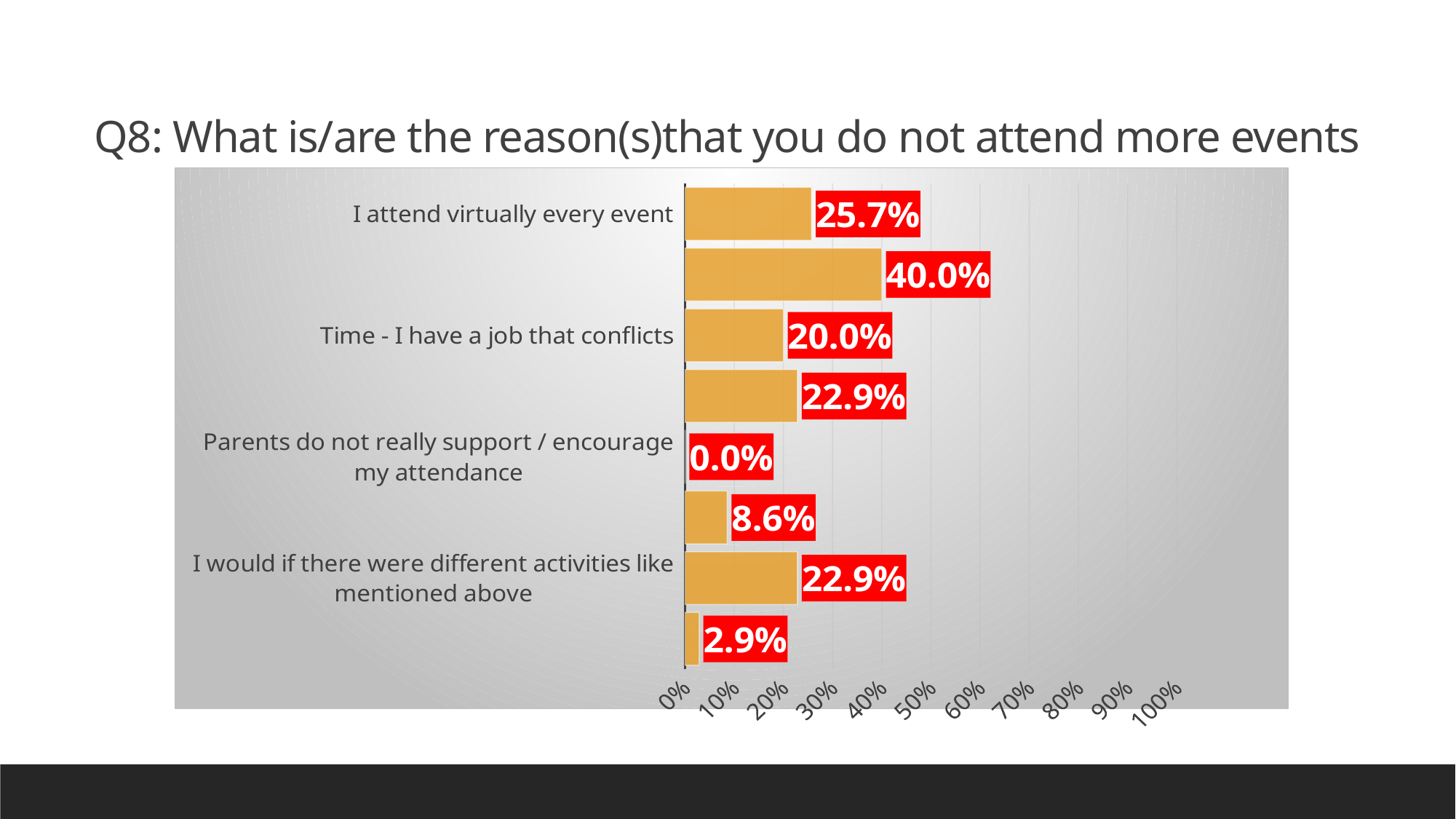
What kind of chart is shown on the slide? bar chart What is the highest value shown on the chart? 40.0% What percentage of respondents chose "I attend virtually every event"? 25.7% What is the value for "I would if there were different activities like mentioned above"? 22.9% What is the value for "Parents do not really support / encourage my attendance"? 0.0% Which labelled category has the lowest value? Parents do not really support / encourage my attendance Is the value for "Time - I have a job that conflicts" greater or less than 30%? less How many bars are plotted on the chart? 8 Which is larger: the value for "I attend virtually every event" or for "I would if there were different activities like mentioned above"? I attend virtually every event What is the difference between the values for "I attend virtually every event" and "Time - I have a job that conflicts"? 5.7% What is the value for "Time - I have a job that conflicts"? 20.0% What is the maximum value shown on the horizontal axis? 100%